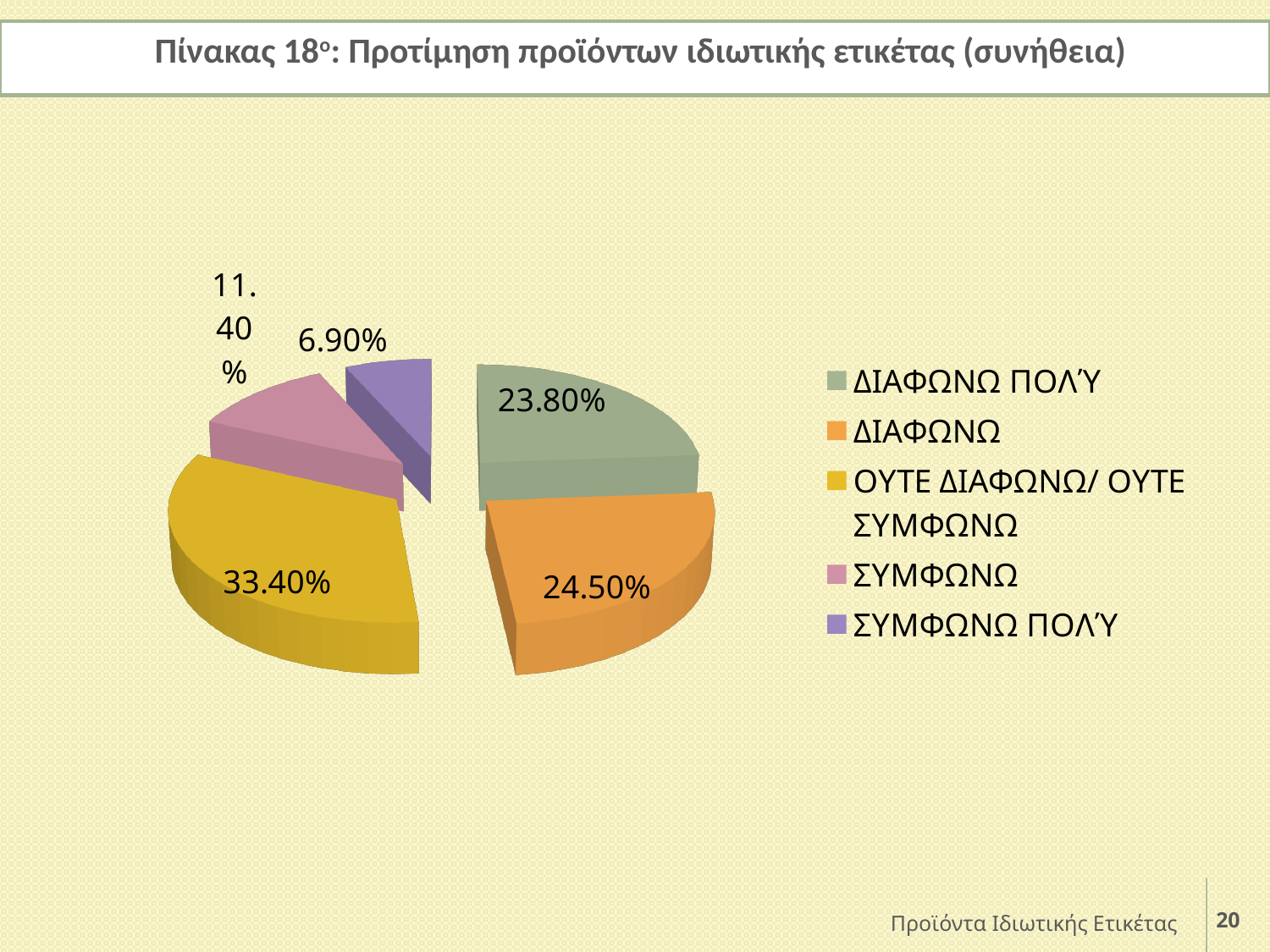
What is the title of the chart on the slide? Πίνακας 18ο: Προτίμηση προϊόντων ιδιωτικής ετικέτας (συνήθεια) What is the value for ΣΥΜΦΩΝΩ ΠΟΛΎ? 6.90% What kind of chart is shown on the slide? Pie chart Which is larger, the value for ΣΥΜΦΩΝΩ or the value for ΣΥΜΦΩΝΩ ΠΟΛΎ? ΣΥΜΦΩΝΩ What is the value for ΔΙΑΦΩΝΩ? 24.50% Which category has the smallest share of the pie? ΣΥΜΦΩΝΩ ΠΟΛΎ What is the value for ΟΥΤΕ ΔΙΑΦΩΝΩ/ ΟΥΤΕ ΣΥΜΦΩΝΩ? 33.40% How many categories does the pie chart have? 5 What is the value for ΔΙΑΦΩΝΩ ΠΟΛΎ? 23.80% Which category has the largest share of the pie? ΟΥΤΕ ΔΙΑΦΩΝΩ/ ΟΥΤΕ ΣΥΜΦΩΝΩ What is the difference between the values for ΟΥΤΕ ΔΙΑΦΩΝΩ/ ΟΥΤΕ ΣΥΜΦΩΝΩ and ΔΙΑΦΩΝΩ? 8.90% What is the value for ΣΥΜΦΩΝΩ? 11.40%